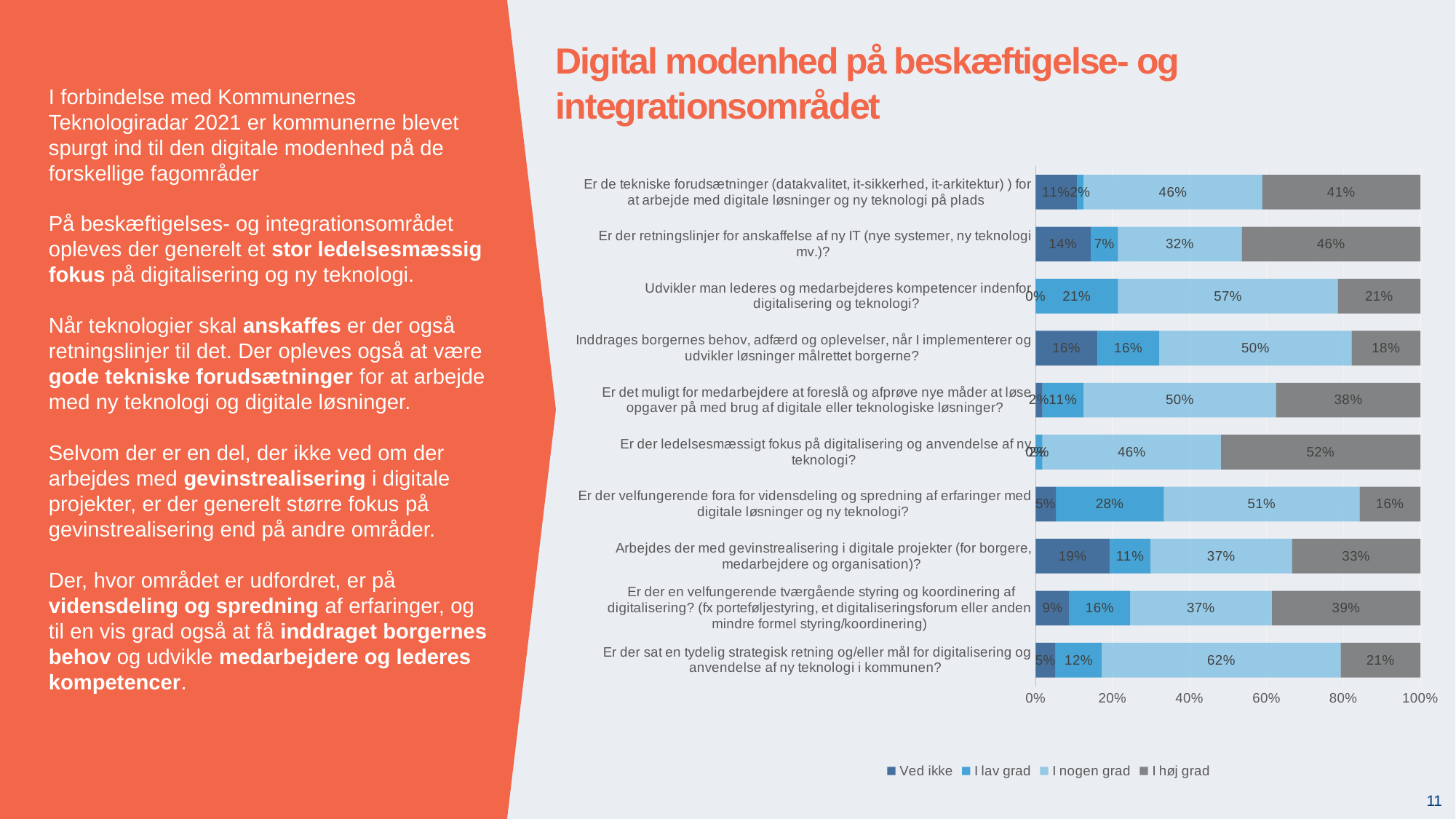
How many series does the legend list? 4 What is the 'I lav grad' value for 'Er der velfungerende fora for vidensdeling og spredning af erfaringer med digitale løsninger og ny teknologi?' 28% What is the 'I høj grad' value for 'Er der retningslinjer for anskaffelse af ny IT (nye systemer, ny teknologi mv.)?' 46% What is the last entry in the chart's legend? I høj grad Which question has the highest 'I høj grad' share? Er der ledelsesmæssigt fokus på digitalisering og anvendelse af ny teknologi? What is the 'Ved ikke' value for 'Arbejdes der med gevinstrealisering i digitale projekter (for borgere, medarbejdere og organisation)?' 19% How many questions (categories) are plotted in the chart? 10 What is the 'I nogen grad' value for 'Er der sat en tydelig strategisk retning og/eller mål for digitalisering og anvendelse af ny teknologi i kommunen?' 62% Which is larger for 'Er der en velfungerende tværgående styring og koordinering af digitalisering?': the 'I nogen grad' value or the 'I høj grad' value? I høj grad What kind of chart is shown on the slide? stacked bar chart What is the difference between the 'I nogen grad' and 'I høj grad' values for 'Udvikler man lederes og medarbejderes kompetencer indenfor digitalisering og teknologi?' 36% Which question has the highest 'Ved ikke' share? Arbejdes der med gevinstrealisering i digitale projekter (for borgere, medarbejdere og organisation)?